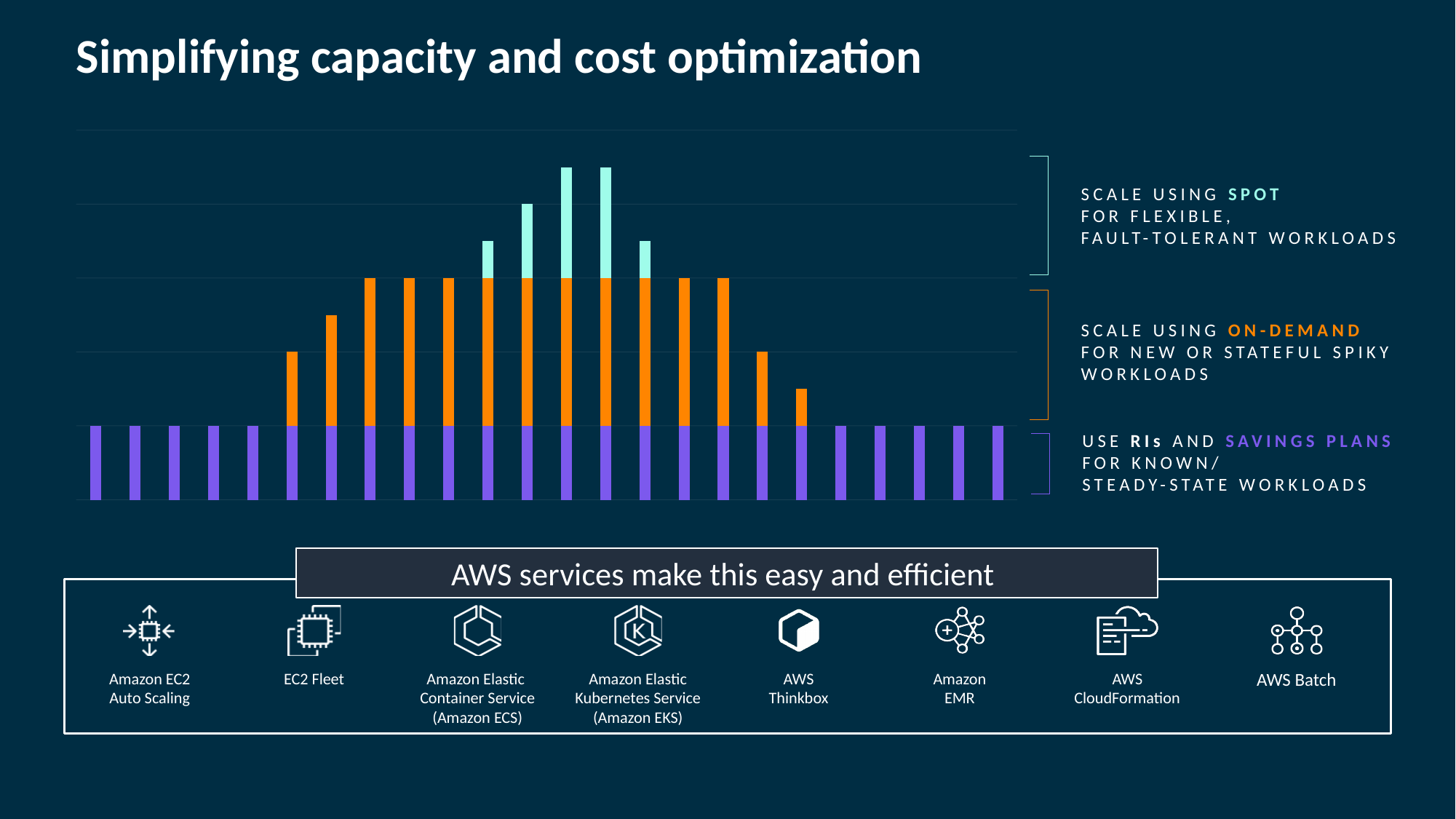
How many capacity types (series) are stacked in the bars, according to the annotations on the right? 3 How many bars are plotted in the chart? 24 Which colour represents Spot capacity in the chart? Light teal Do the bar heights rise or fall from the leftmost bar toward the middle of the chart? Rise How many bars consist only of the RIs and Savings Plans (purple) segment? 10 How many bars include an On-Demand (orange) segment? 14 Do the bar heights rise or fall from the middle of the chart toward the rightmost bar? Fall Which capacity type forms the bottom segment of every bar? RIs and Savings Plans What kind of chart is shown on the slide? Stacked bar chart